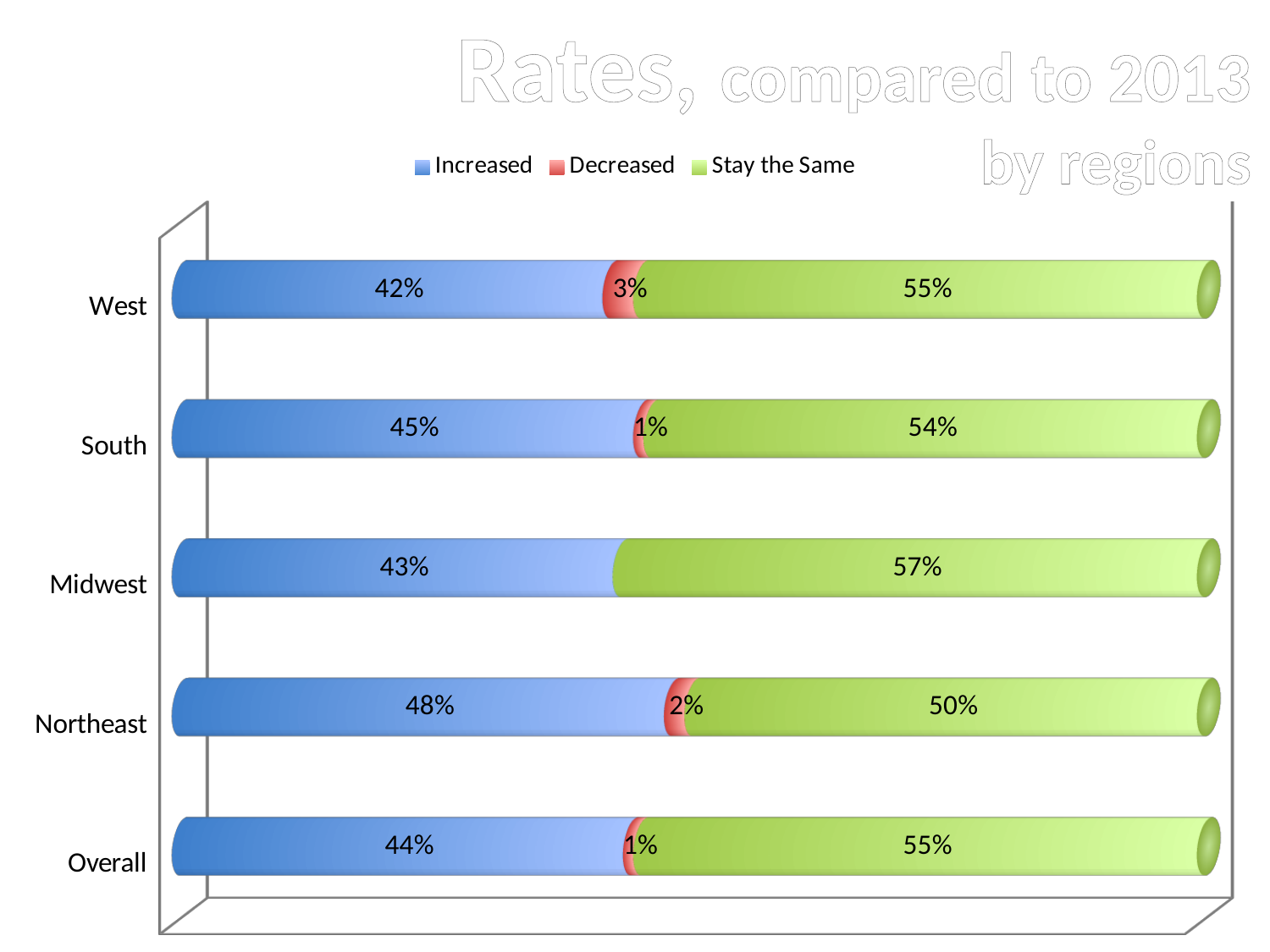
What is the title of the chart? Rates, compared to 2013 by regions Which is larger, the Increased value for South or for Midwest? South What kind of chart is shown on the slide? Stacked bar chart What percentage of the West region reported rates Increased? 42% What is the Decreased value for the South region? 1% Which region has the highest Decreased percentage? West How many regions (categories) are shown in the chart? 5 How many series does the legend list? 3 Which region has the lowest Stay the Same percentage? Northeast What percentage of the Northeast region reported rates Stay the Same? 50% Which region has the highest Increased percentage? Northeast What is the difference between the Stay the Same values for Midwest and Northeast? 7%